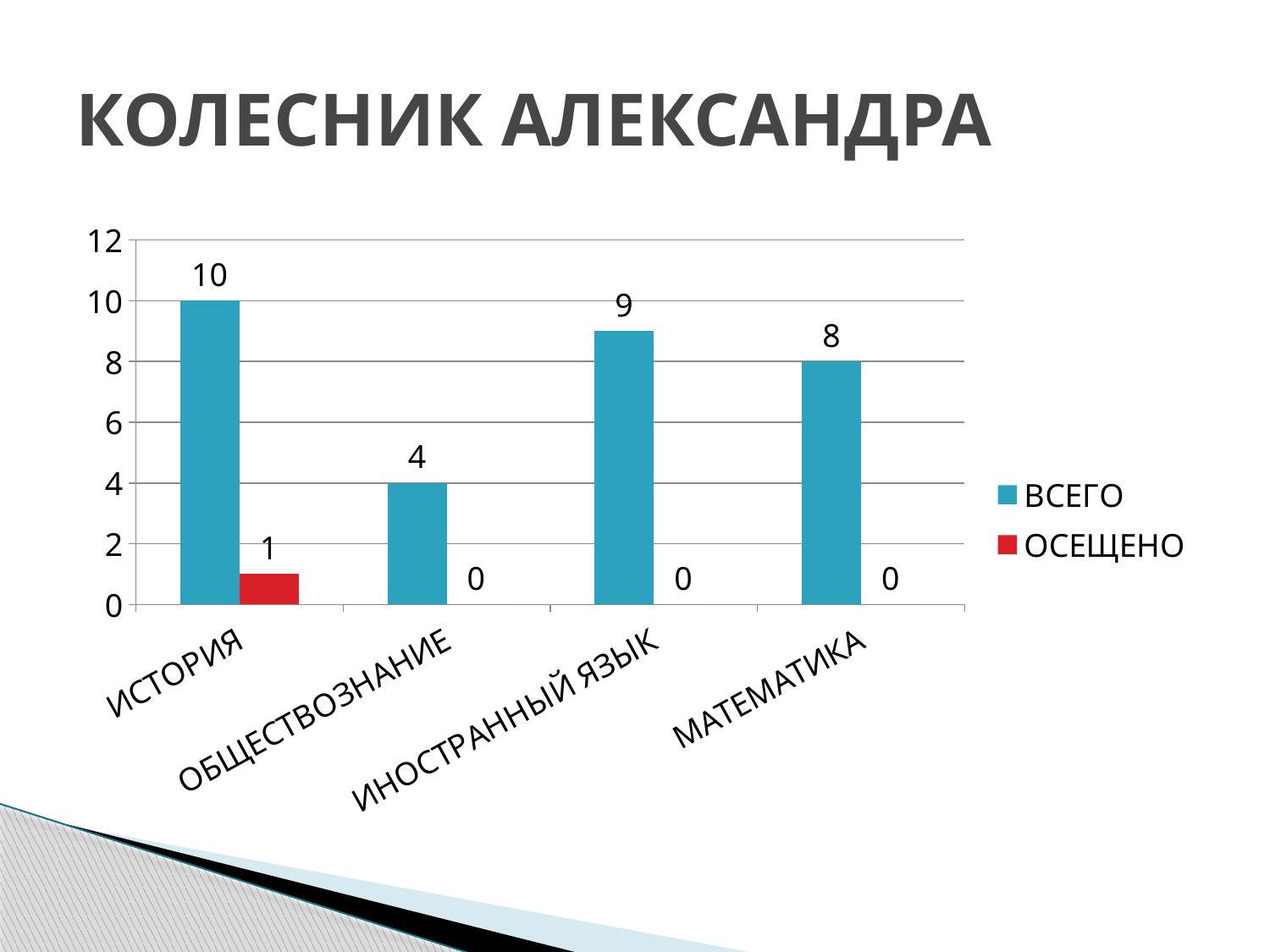
How many categories are shown on the x axis? 4 Which category has the highest ВСЕГО value? ИСТОРИЯ What is the ВСЕГО value for ИНОСТРАННЫЙ ЯЗЫК? 9 How many series does the legend list? 2 What is the ОСЕЩЕНО value for МАТЕМАТИКА? 0 What is the ВСЕГО value for ОБЩЕСТВОЗНАНИЕ? 4 What is the difference between the ВСЕГО values for ИСТОРИЯ and МАТЕМАТИКА? 2 Which category has the lowest ВСЕГО value? ОБЩЕСТВОЗНАНИЕ What kind of chart is shown on the slide? bar chart Which has a larger ВСЕГО value, ИНОСТРАННЫЙ ЯЗЫК or ОБЩЕСТВОЗНАНИЕ? ИНОСТРАННЫЙ ЯЗЫК What is the ВСЕГО value for ИСТОРИЯ? 10 What is the ОСЕЩЕНО value for ИСТОРИЯ? 1